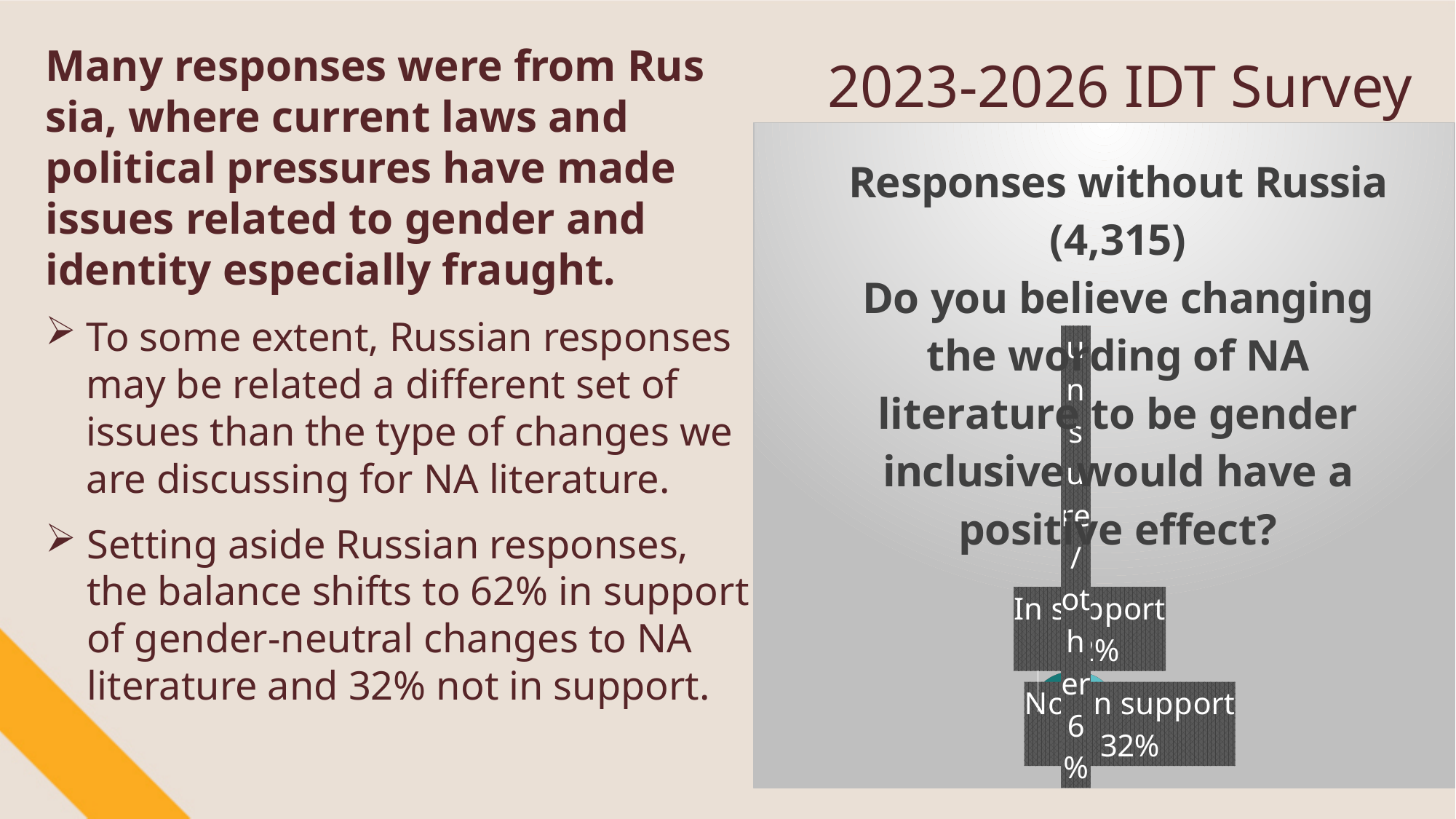
What survey question does the chart title say the responses are for? Do you believe changing the wording of NA literature to be gender inclusive would have a positive effect? What percentage of responses were 'Unsure/other' in the Responses without Russia chart? 6% How many response categories does the Responses without Russia chart show? 3 By how many percentage points does 'Not in support' exceed 'Unsure/other' in the Responses without Russia chart? 26 percentage points Which category has the largest share in the Responses without Russia chart? In support What percentage of responses were 'Not in support' in the Responses without Russia chart? 32% Which category has the smallest share in the Responses without Russia chart? Unsure/other How many responses does the chart title say were counted without Russia? 4,315 Which is larger in the Responses without Russia chart: 'Not in support' or 'Unsure/other'? Not in support